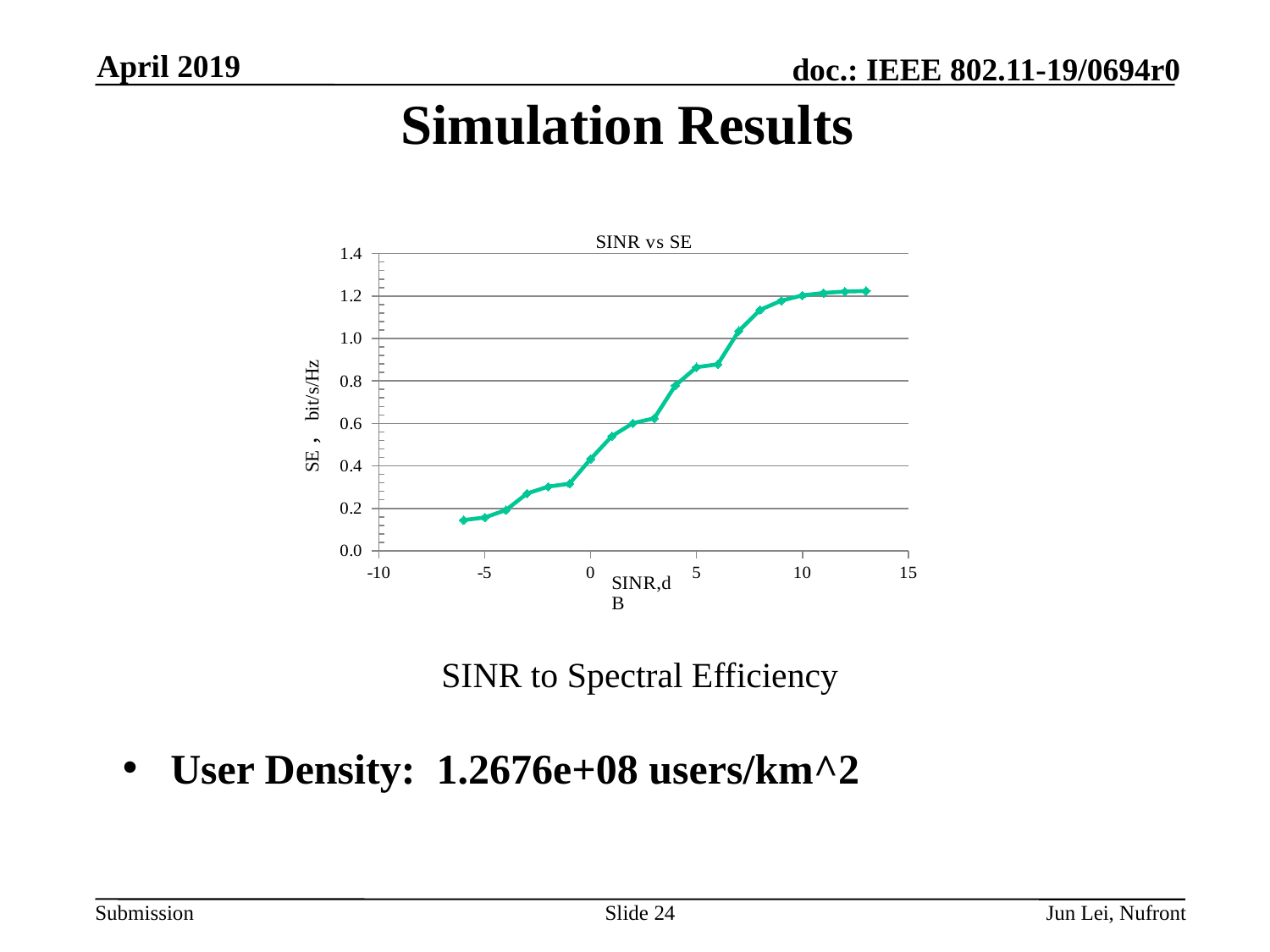
Is the SE value at SINR 10 dB greater or less than 1.0? greater What is the title of the chart? SINR vs SE Does the SE value rise or fall as SINR increases along the x axis? rise Is the SE value at SINR -5 dB greater or less than 0.2? less Is the SE value at SINR 5 dB greater or less than 0.8? greater At which end of the x axis does the curve reach its highest SE value, the left or the right? right Which has the higher SE value: the point at SINR 5 dB or the point at SINR -5 dB? SINR 5 dB What type of chart is shown on the slide? line chart What is the label of the y axis of the chart? SE, bit/s/Hz